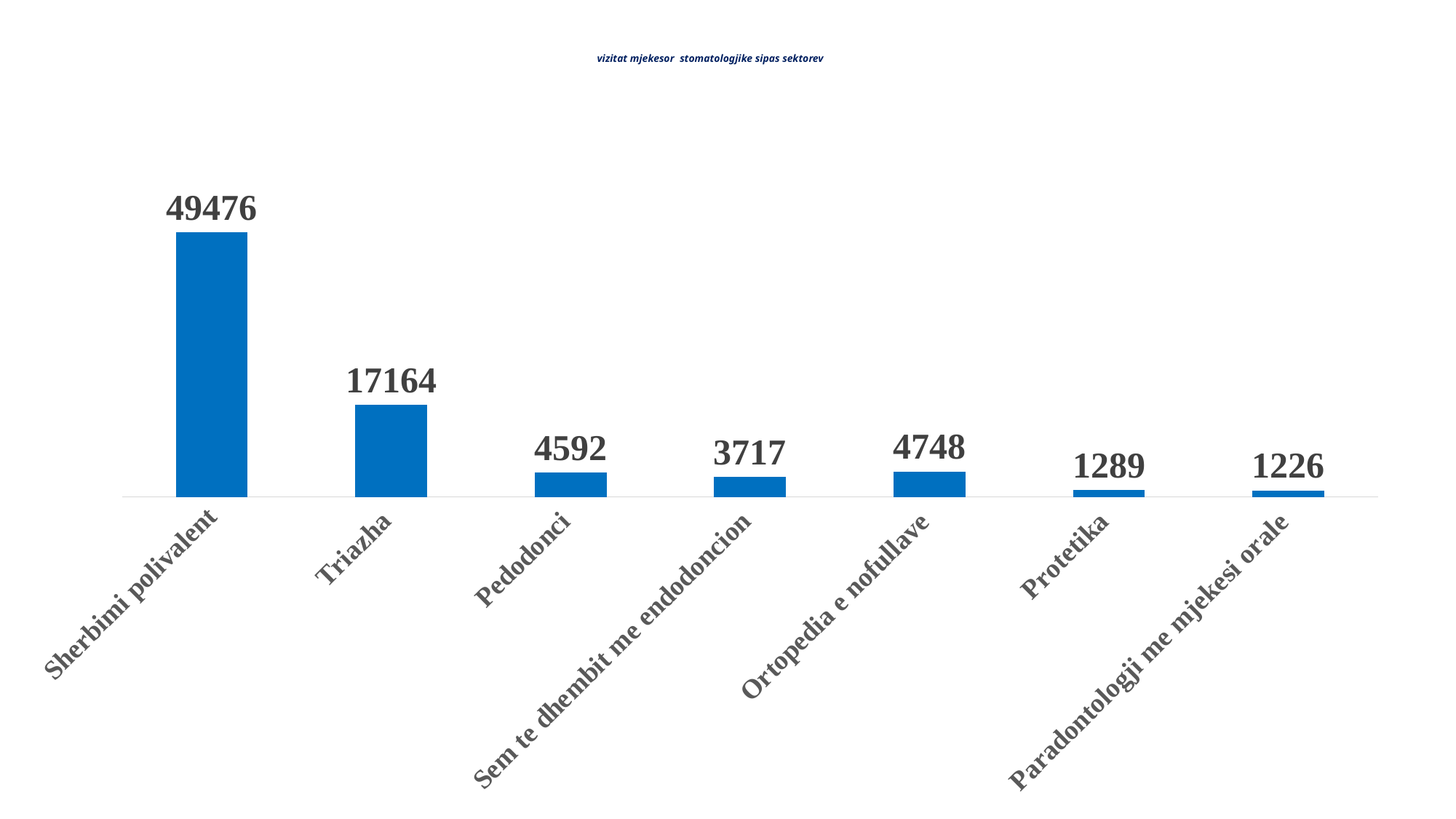
How many categories are shown in the chart? 7 Which is larger, the value for Ortopedia e nofullave or the value for Pedodonci? Ortopedia e nofullave What is the title of the chart? vizitat mjekesor stomatologjike sipas sektorev What kind of chart is shown on the slide? Bar chart What is the value for Ortopedia e nofullave? 4748 What is the difference between the values for Pedodonci and Sem te dhembit me endodoncion? 875 Which category has the lowest value? Paradontologji me mjekesi orale Which category has the highest value? Sherbimi polivalent What is the value for Paradontologji me mjekesi orale? 1226 What is the value for Triazha? 17164 What is the value for Sherbimi polivalent? 49476 What is the difference between the values for Sherbimi polivalent and Triazha? 32312